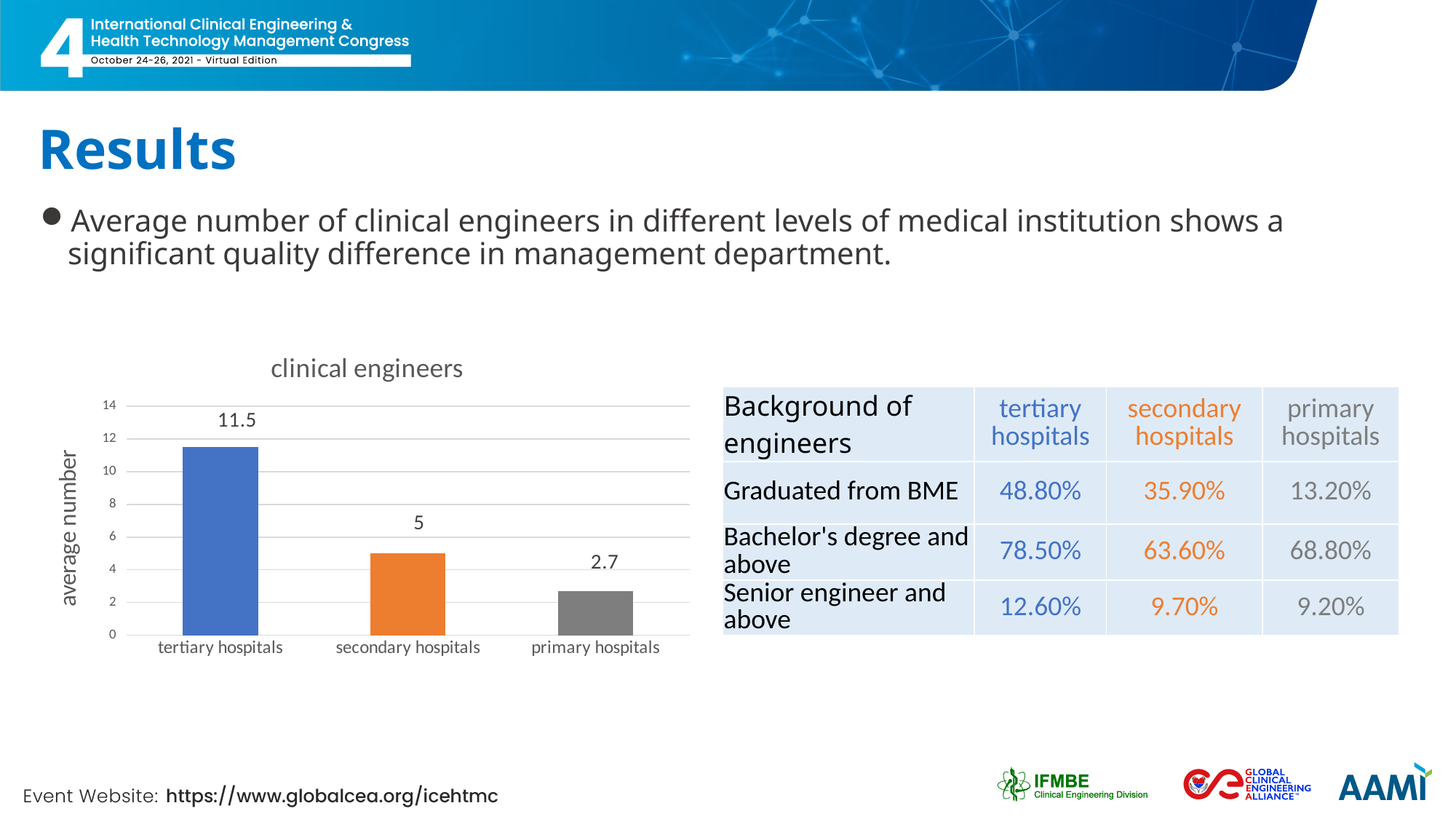
What is the average number of clinical engineers for primary hospitals? 2.7 Is the average number of clinical engineers for tertiary hospitals greater or less than 10? greater What is the difference between the average number of clinical engineers in secondary hospitals and primary hospitals? 2.3 How many hospital categories are shown in the chart? 3 Which has a larger average number of clinical engineers, secondary hospitals or primary hospitals? secondary hospitals What is the title of the chart? clinical engineers Which hospital level has the lowest average number of clinical engineers? primary hospitals What is the difference between the average number of clinical engineers in tertiary hospitals and secondary hospitals? 6.5 What type of chart is used to show the average number of clinical engineers? bar chart What is the average number of clinical engineers for tertiary hospitals? 11.5 What is the average number of clinical engineers for secondary hospitals? 5 Which hospital level has the highest average number of clinical engineers? tertiary hospitals